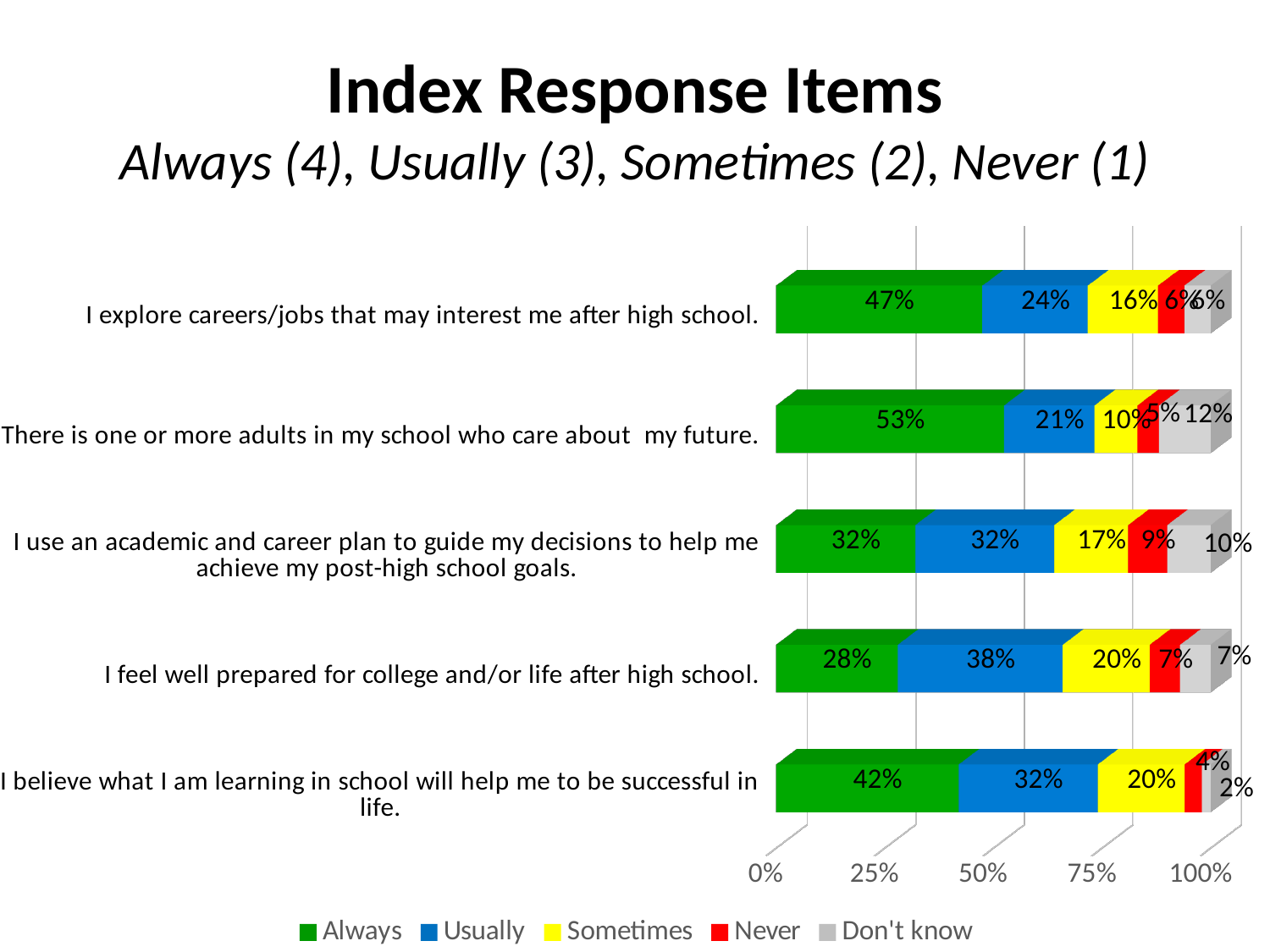
What percentage answered "Sometimes" to "I believe what I am learning in school will help me to be successful in life."? 20% What colour represents the "Never" series in the chart? Red What percentage answered "Usually" to "I feel well prepared for college and/or life after high school."? 38% How many response items (bars) are plotted in the chart? 5 What percentage answered "Always" to "I explore careers/jobs that may interest me after high school."? 47% What kind of chart is shown on the slide? Stacked bar chart For "There is one or more adults in my school who care about my future.", what is the difference between the "Always" and "Usually" percentages? 32 percentage points How many series does the legend list? 5 What percentage answered "Don't know" to "I use an academic and career plan to guide my decisions to help me achieve my post-high school goals."? 10% Which item has the highest "Always" percentage? There is one or more adults in my school who care about my future. Which item has the lowest "Always" percentage? I feel well prepared for college and/or life after high school. For "I feel well prepared for college and/or life after high school.", which is larger: the "Always" or the "Usually" percentage? Usually